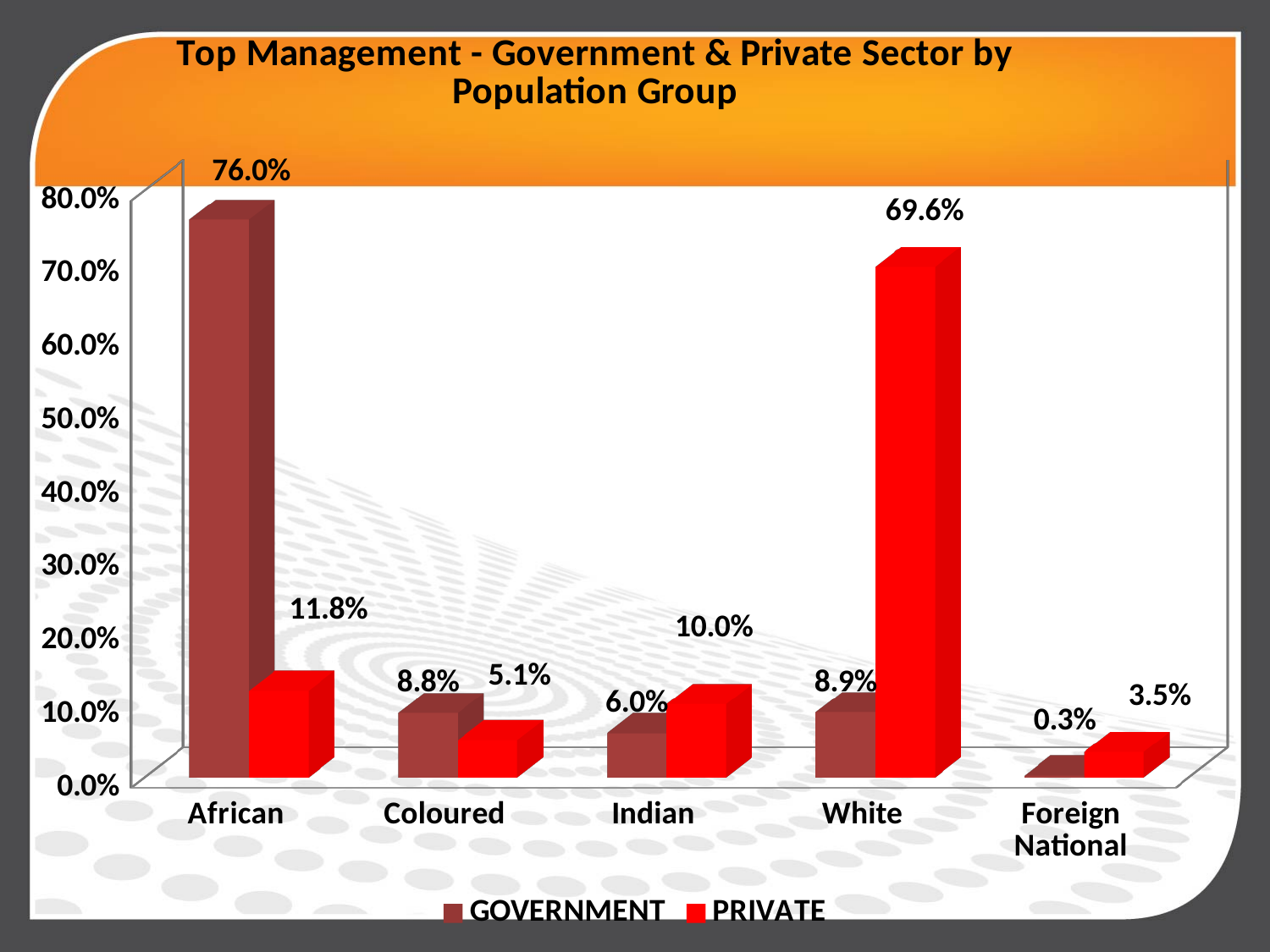
What is the title of the chart? Top Management - Government & Private Sector by Population Group Which population group has the highest GOVERNMENT value? African What kind of chart is shown on the slide? Bar chart Which population group has the lowest PRIVATE value? Foreign National What is the PRIVATE value for Foreign National? 3.5% What is the GOVERNMENT value for Coloured? 8.8% How many population groups are shown on the x axis? 5 What is the difference between the GOVERNMENT and PRIVATE values for African? 64.2% How many series does the legend list? 2 What is the PRIVATE value for White? 69.6% Which is larger for Indian: the GOVERNMENT value or the PRIVATE value? PRIVATE What is the GOVERNMENT value for African? 76.0%